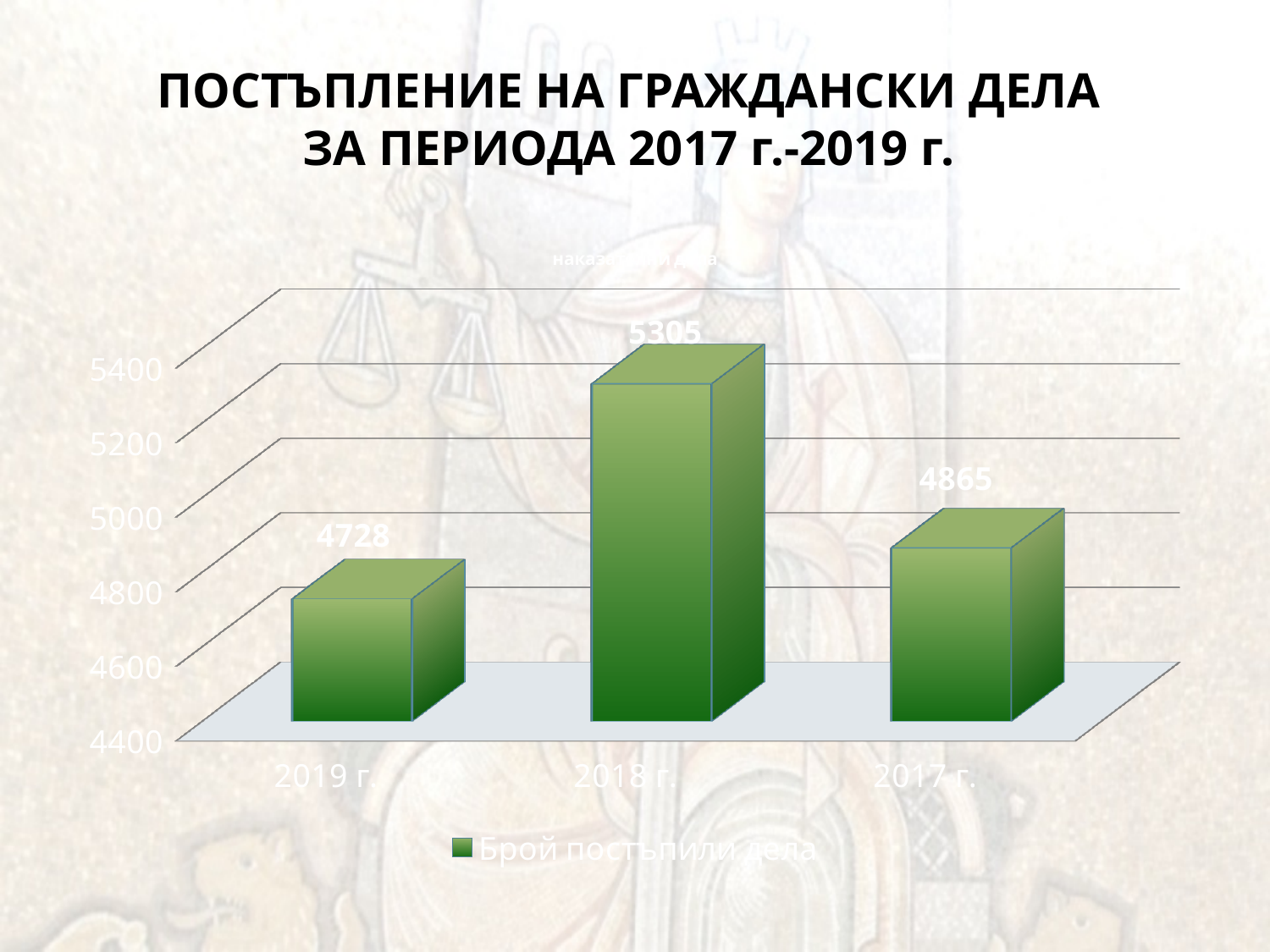
Is the value for 2018 г. greater or less than 5200? greater What kind of chart is shown on the slide? bar chart What is the difference between the values for 2017 г. and 2019 г.? 137 What is the value for 2017 г.? 4865 What is the value for 2019 г.? 4728 What series name does the legend show? Брой постъпили дела What is the value for 2018 г.? 5305 How many categories are shown on the x axis? 3 Which year has the highest number of cases? 2018 г. What is the difference between the values for 2018 г. and 2019 г.? 577 Which year has the lowest number of cases? 2019 г. Which is larger, the value for 2017 г. or the value for 2019 г.? 2017 г.